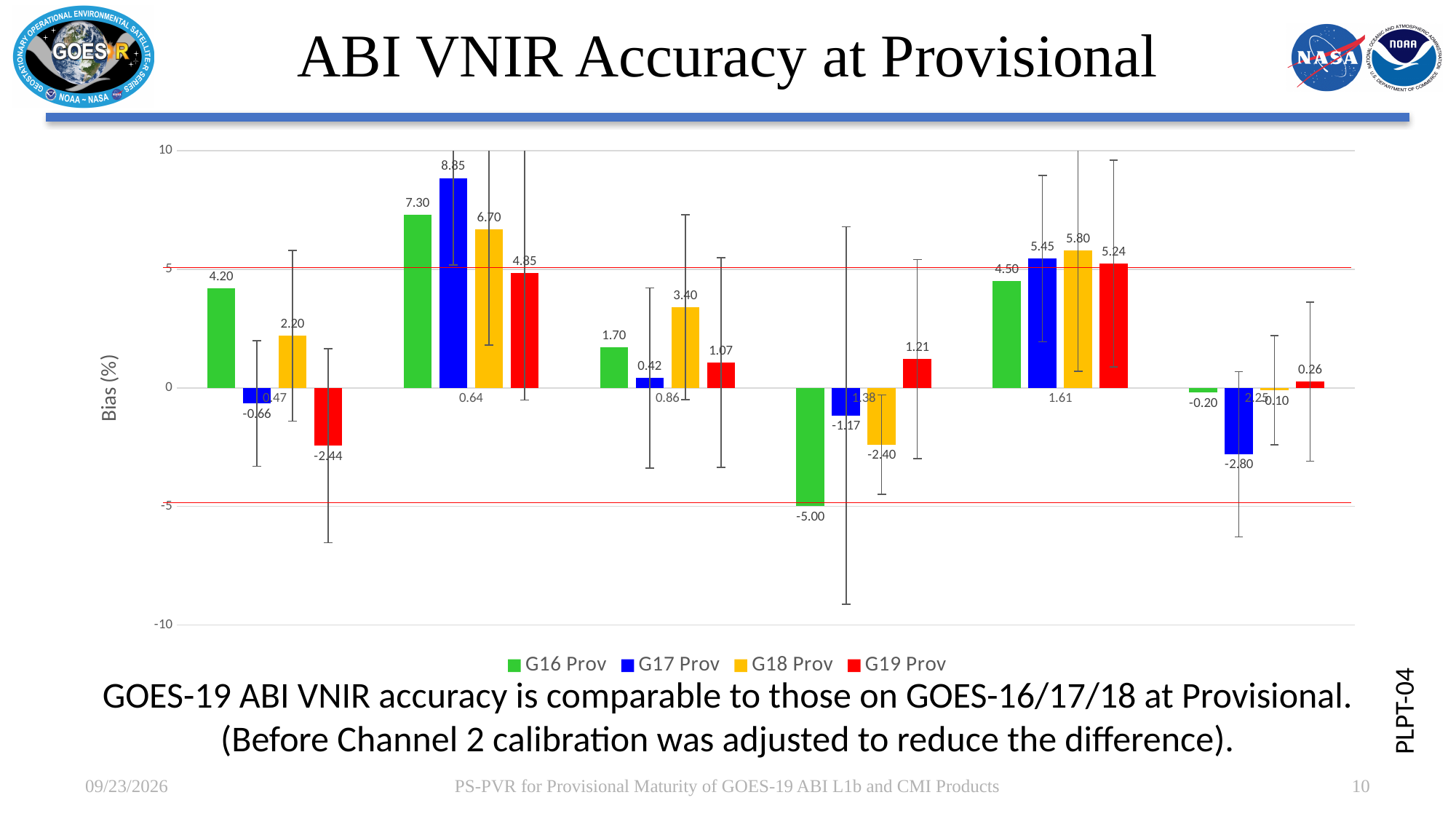
What is the value of the G19 Prov bar in the first group of bars from the left? -2.44 How many groups of bars are plotted along the x axis? 6 Which series is shown in red in the legend? G19 Prov What is the difference between the G16 Prov and G19 Prov values in the second group of bars from the left? 2.45 What is the label of the vertical axis? Bias (%) What is the value of the G16 Prov bar in the fourth group of bars from the left? -5.00 How many series does the legend list? 4 In the sixth group of bars from the left, which series has the lowest value? G17 Prov What kind of chart is shown on the slide? bar chart In the fifth group of bars from the left, which series has the highest value? G18 Prov In the third group of bars from the left, which is larger: the G18 Prov value or the G19 Prov value? G18 Prov What is the value of the G17 Prov bar in the second group of bars from the left? 8.85